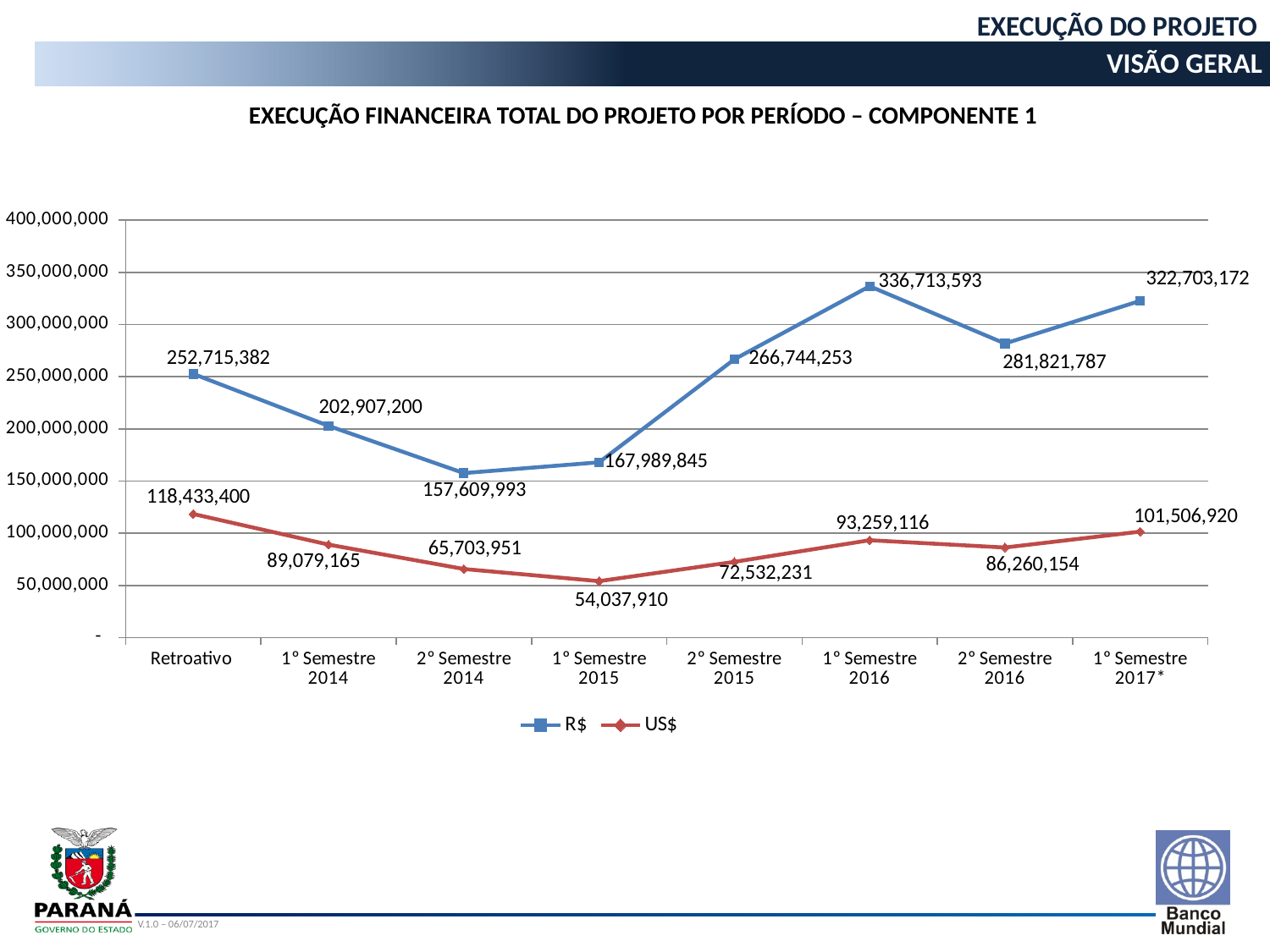
Which period has the lowest US$ value? 1° Semestre 2015 What is the US$ value for 2° Semestre 2014? 65,703,951 Which is larger, the R$ value for 2° Semestre 2015 or the R$ value for 1° Semestre 2017*? 1° Semestre 2017* What kind of chart is shown on the slide? line chart How many periods are shown on the x axis? 8 What is the difference between the US$ values for Retroativo and 1° Semestre 2015? 64,395,490 Is the US$ value for 1° Semestre 2017* greater or less than 100,000,000? greater What is the R$ value for 1° Semestre 2016? 336,713,593 What is the difference between the R$ values for 1° Semestre 2016 and 2° Semestre 2016? 54,891,806 How many series does the legend list? 2 What is the R$ value for Retroativo? 252,715,382 Which period has the highest R$ value? 1° Semestre 2016